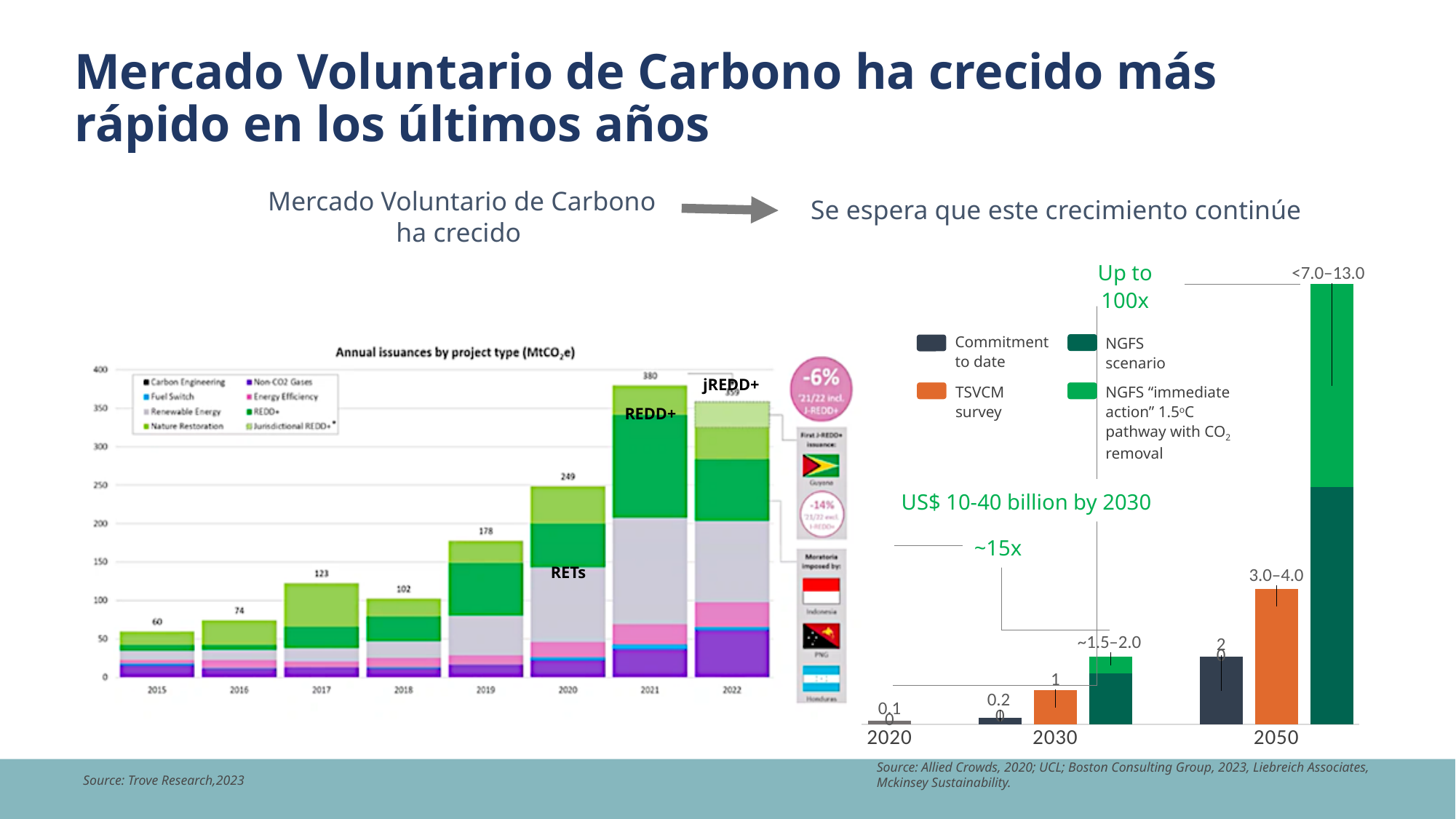
In the left chart 'Annual issuances by project type', what is the difference between the 2021 total and the 2020 total? 131 In the left chart 'Annual issuances by project type', which year has the larger total issuance, 2017 or 2018? 2017 In the right chart, how many series does the legend list? 4 In the right chart, what is the value of the TSVCM survey bar for 2030? 1 What kind of chart is the left chart 'Annual issuances by project type'? Stacked bar chart In the left chart 'Annual issuances by project type', how many years are shown on the x axis? 8 In the right chart, what is the value of the TSVCM survey bar for 2050? 3.0–4.0 In the left chart 'Annual issuances by project type', how many project types does the legend list? 8 In the left chart 'Annual issuances by project type', which year has the highest total issuance? 2021 In the left chart 'Annual issuances by project type', which year has the lowest total issuance? 2015 In the left chart 'Annual issuances by project type', what is the total annual issuance for 2021? 380 In the left chart 'Annual issuances by project type', what is the total annual issuance for 2020? 249